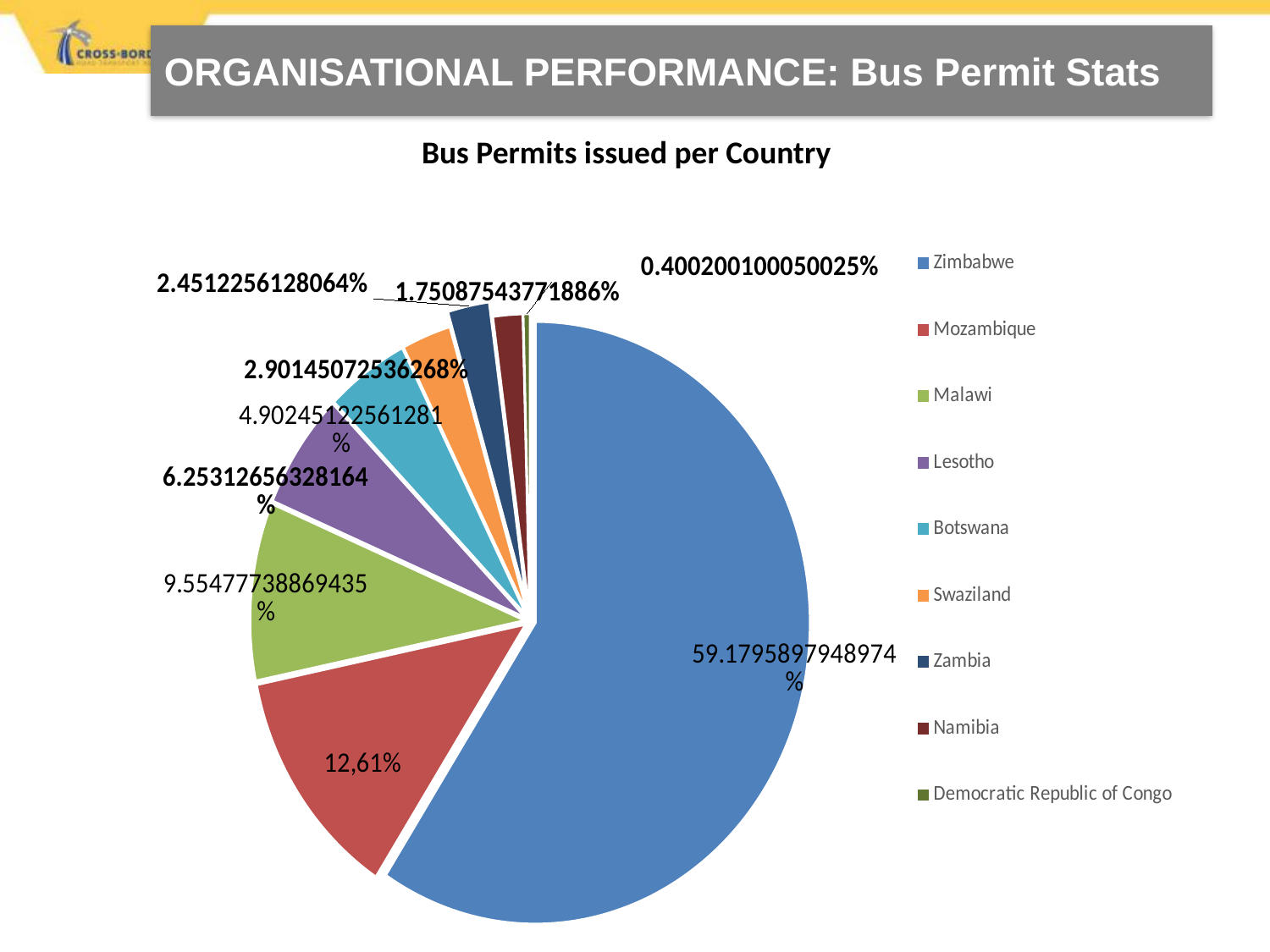
What percentage of bus permits was issued for Lesotho? 6.25312656328164% What is the title of the chart? Bus Permits issued per Country What percentage of bus permits was issued for Botswana? 4.90245122561281% What percentage of bus permits was issued for Zimbabwe? 59.1795897948974% What percentage of bus permits was issued for the Democratic Republic of Congo? 0.400200100050025% Which country has the smallest share of bus permits issued? Democratic Republic of Congo Which country has the largest share of bus permits issued? Zimbabwe Which country has a larger share of bus permits, Malawi or Lesotho? Malawi What percentage of bus permits was issued for Malawi? 9.55477738869435% What percentage of bus permits was issued for Mozambique? 12,61% How many countries are listed in the chart's legend? 9 What kind of chart is shown on the slide? Pie chart